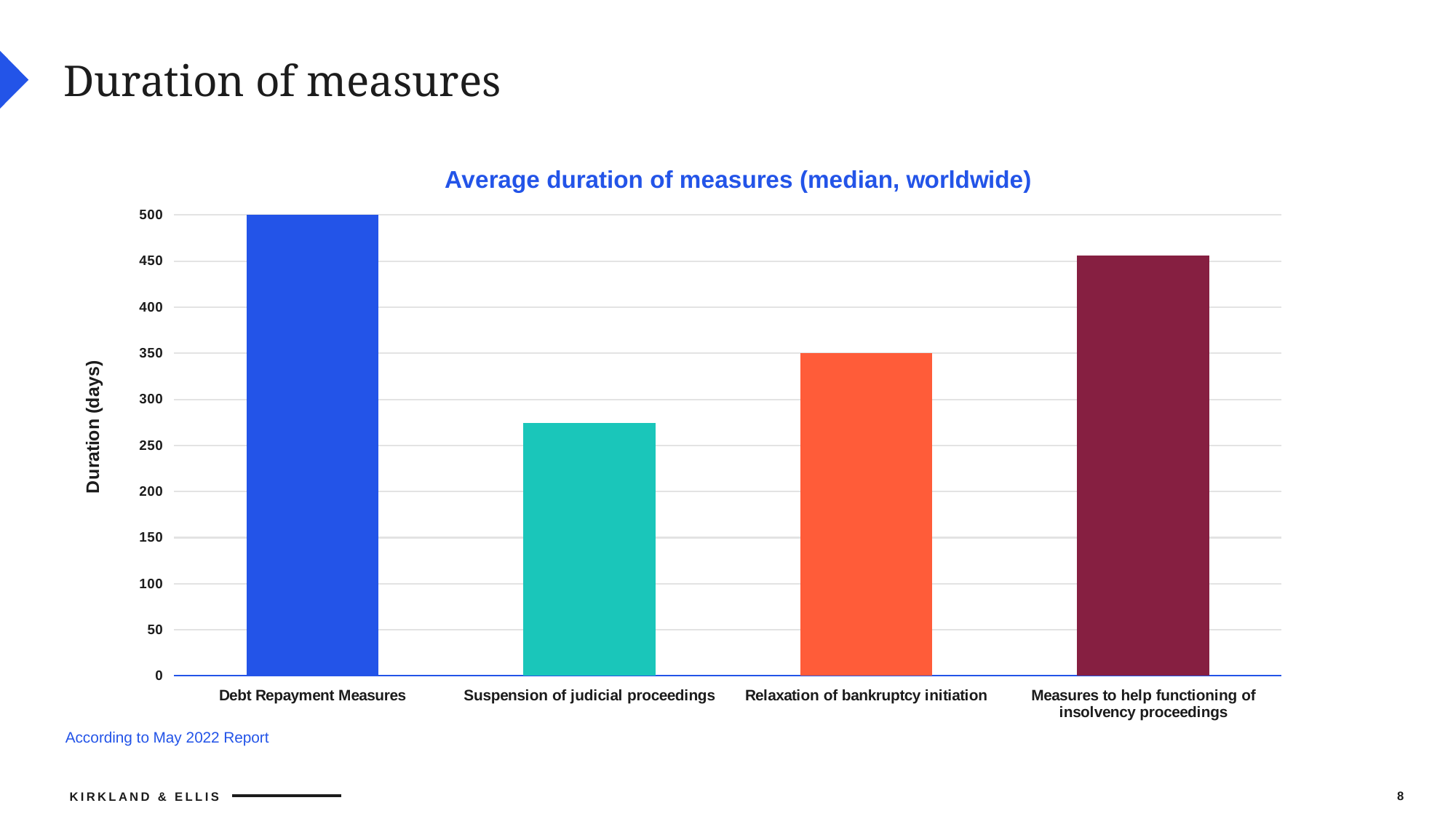
What is the value for Relaxation of bankruptcy initiation? 350 What is the label of the vertical axis? Duration (days) Which is larger: the value for Measures to help functioning of insolvency proceedings or the value for Relaxation of bankruptcy initiation? Measures to help functioning of insolvency proceedings Which category has the lowest duration? Suspension of judicial proceedings What is the title of the chart? Average duration of measures (median, worldwide) Is the value for Suspension of judicial proceedings greater or less than 300? less How many categories are shown in the chart? 4 What is the difference between the values for Debt Repayment Measures and Relaxation of bankruptcy initiation? 150 What kind of chart is shown on the slide? Bar chart Which category has the highest duration? Debt Repayment Measures Is the value for Measures to help functioning of insolvency proceedings greater or less than 400? greater What is the value for Debt Repayment Measures? 500